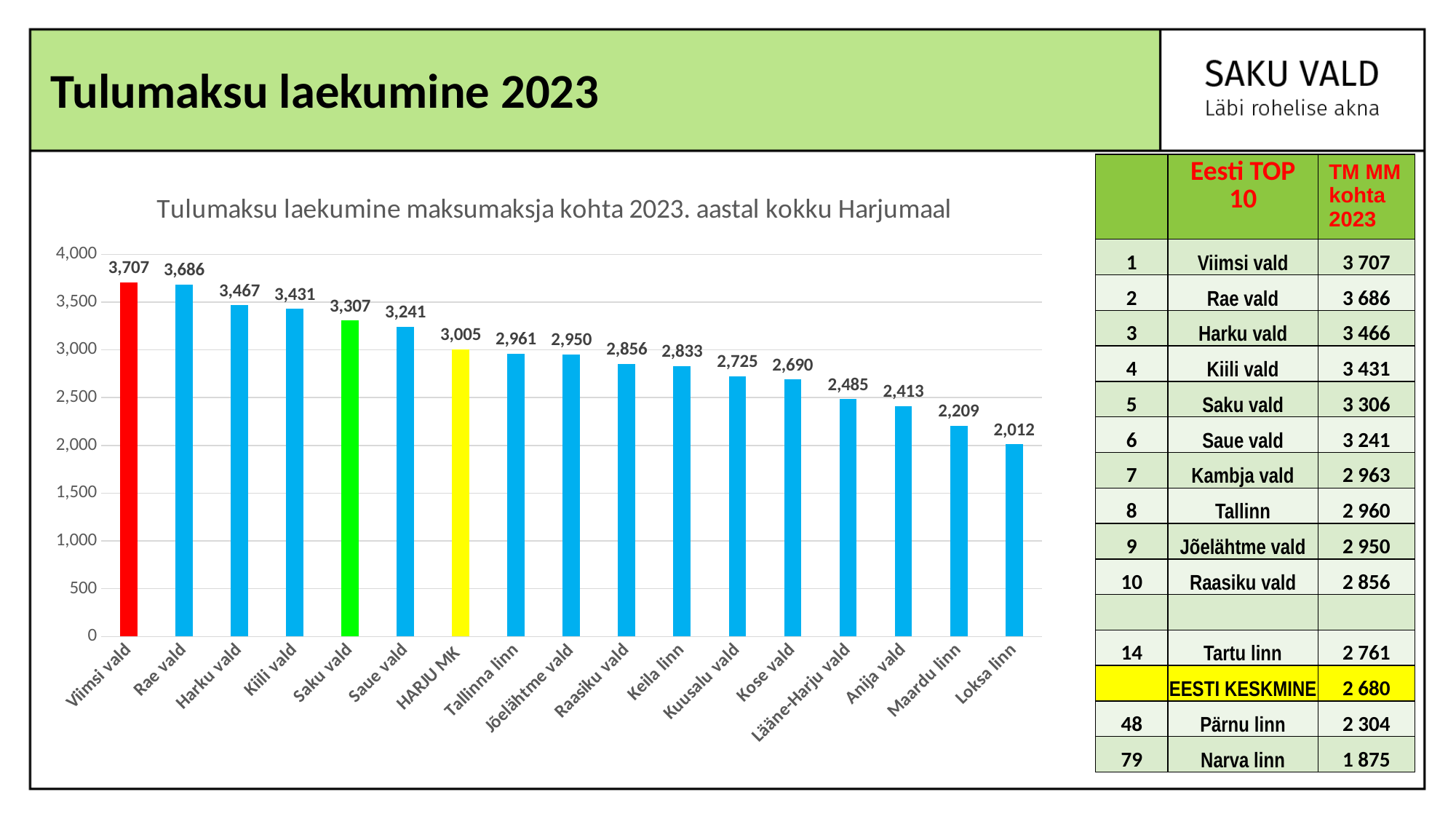
What colour is the bar for Saku vald? Green How many categories are shown in the chart? 17 What is the difference between the values for Viimsi vald and Rae vald? 21 What is the difference between the values for Saku vald and HARJU MK? 302 What is the value for Loksa linn in the chart? 2,012 What is the value for Saku vald in the chart? 3,307 Which category has the highest value in the chart? Viimsi vald What is the value for HARJU MK in the chart? 3,005 Which is larger, the value for Tallinna linn or the value for Jõelähtme vald? Tallinna linn Which category has the lowest value in the chart? Loksa linn Do the values rise or fall from left to right along the x axis? Fall What kind of chart is shown on the slide? Bar chart